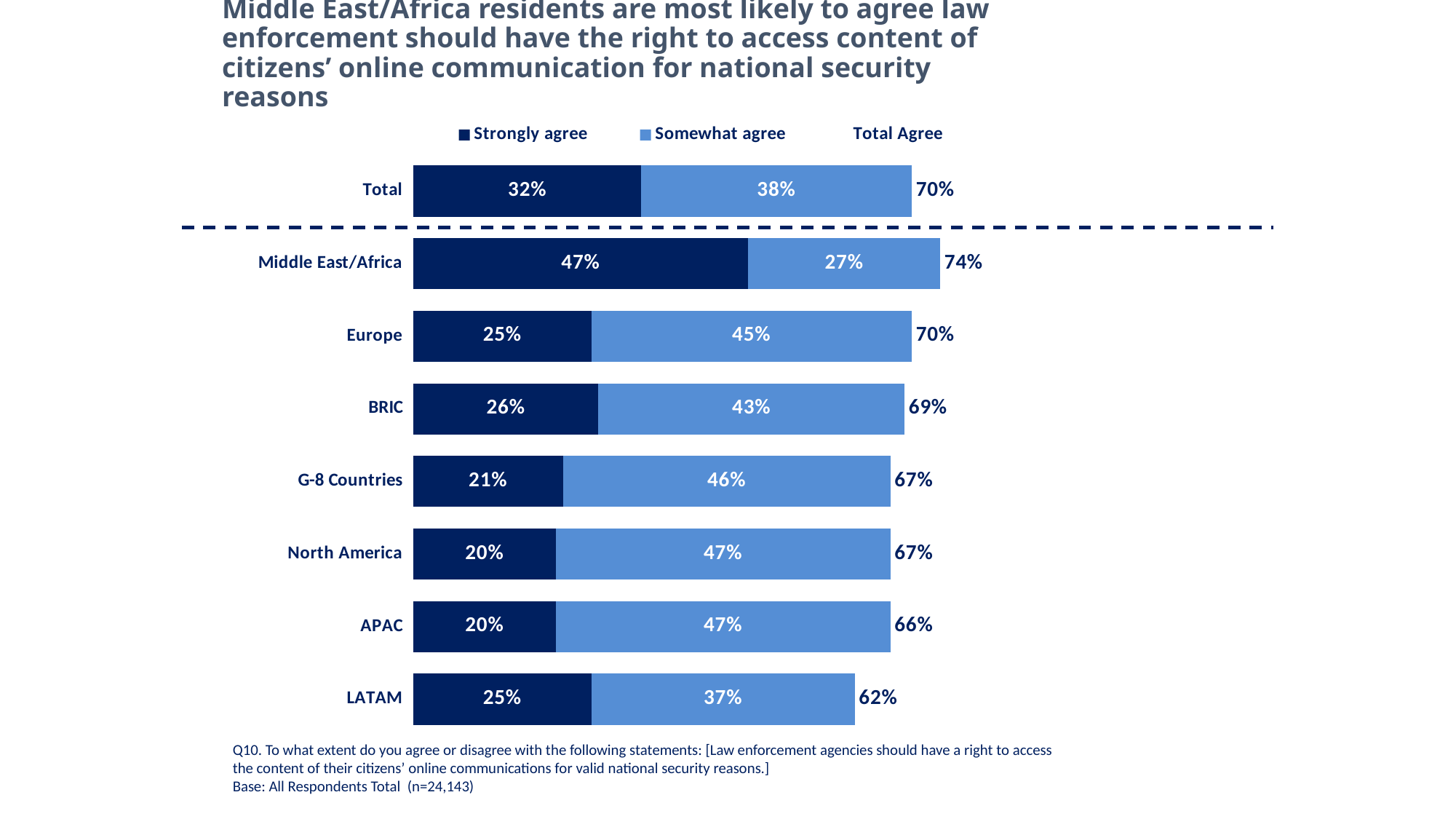
What is the Total Agree value for LATAM? 62% What is the total of the stacked bar for North America? 67% How many region bars are shown below the dashed line? 7 Which colour represents Strongly agree in the chart? Dark navy blue Which region has the highest Strongly agree percentage? Middle East/Africa What kind of chart is shown on the slide? Stacked bar chart What is the difference between the Strongly agree values for Middle East/Africa and Europe? 22% What is the Somewhat agree value for Europe? 45% How many series does the legend list with coloured markers? 2 What percentage of Middle East/Africa respondents strongly agree? 47% Which is larger, the Somewhat agree value for BRIC or for G-8 Countries? G-8 Countries Which region has the lowest Total Agree percentage? LATAM